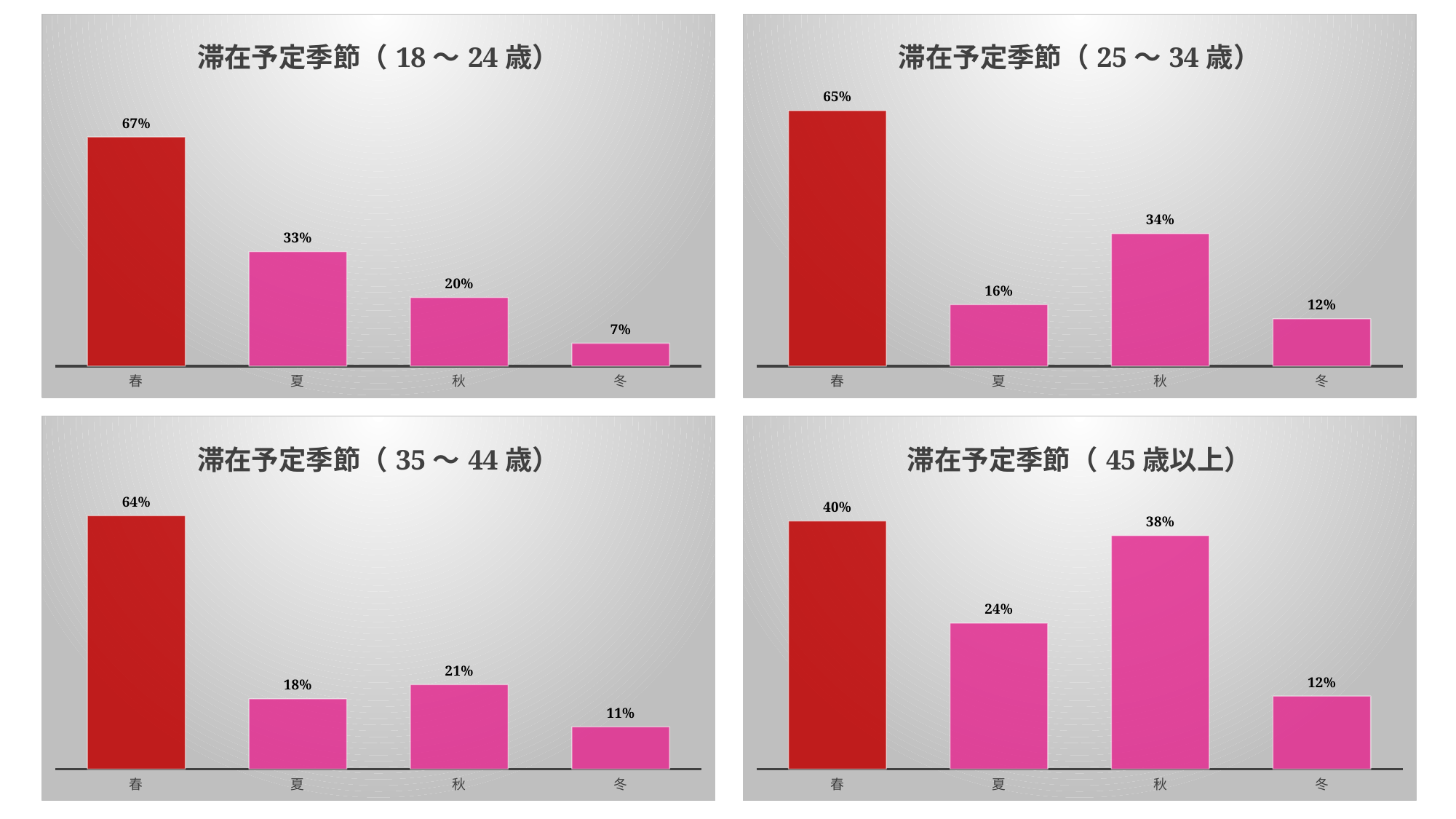
In the chart titled 滞在予定季節（25～34歳）, what is the difference between the values for 春 and 秋? 31% How many charts are shown on the slide? 4 In the chart titled 滞在予定季節（18～24歳）, which season has the lowest value? 冬 In the chart titled 滞在予定季節（45歳以上）, which season has the highest value? 春 In the chart titled 滞在予定季節（45歳以上）, what is the difference between the values for 秋 and 冬? 26% In the chart titled 滞在予定季節（18～24歳）, what is the value for 春? 67% In the chart titled 滞在予定季節（35～44歳）, what is the value for 冬? 11% How many categories are shown in the chart titled 滞在予定季節（18～24歳）? 4 In the chart titled 滞在予定季節（45歳以上）, what is the value for 夏? 24% In the chart titled 滞在予定季節（35～44歳）, which is larger, the value for 夏 or the value for 秋? 秋 In the chart titled 滞在予定季節（25～34歳）, what is the value for 秋? 34% What kind of chart is the chart titled 滞在予定季節（25～34歳）? Bar chart